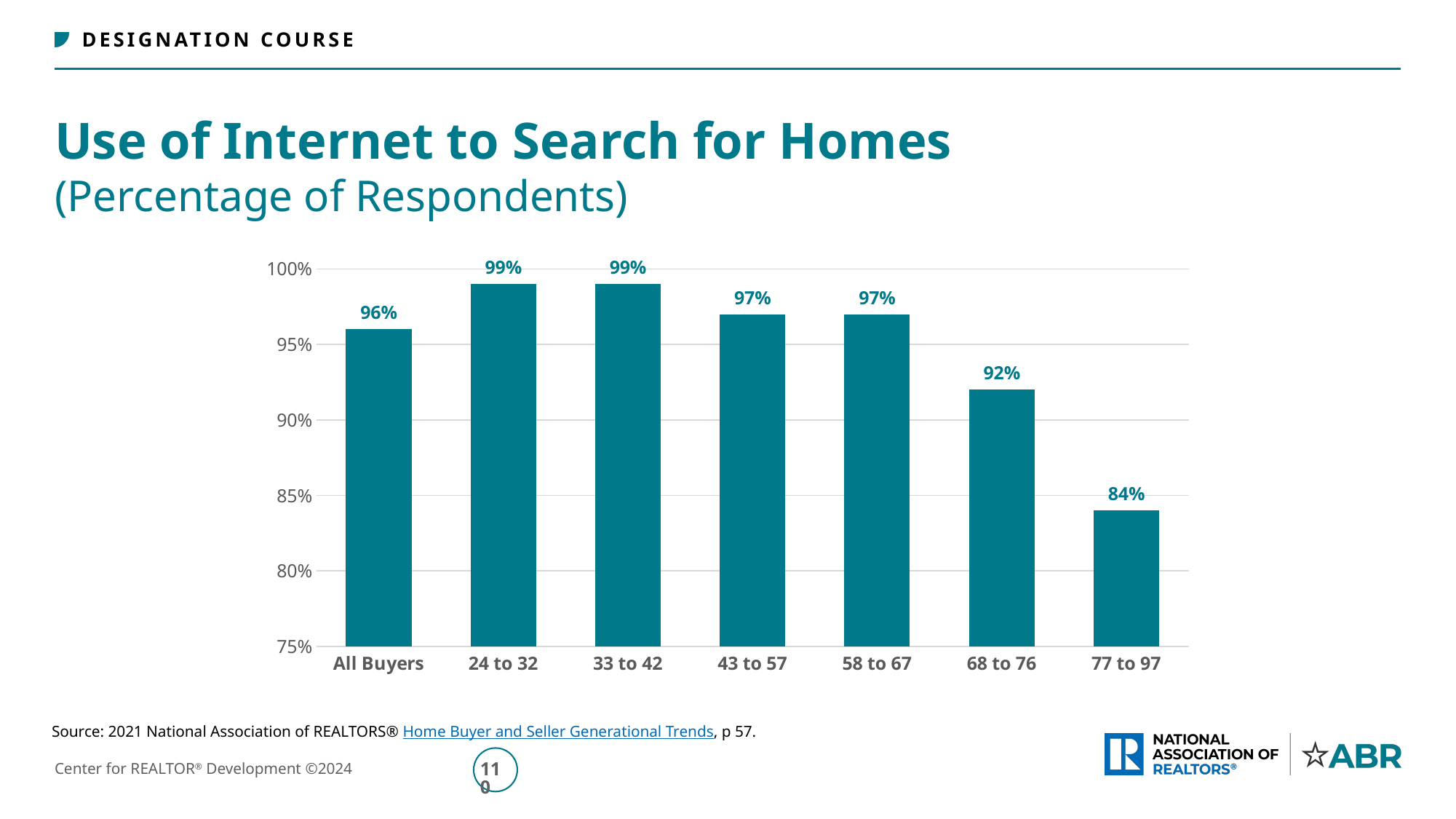
What is the difference between the values for 24 to 32 and 77 to 97? 15% Do the values rise or fall from the 33 to 42 group to the 77 to 97 group? Fall What percentage of All Buyers used the internet to search for homes? 96% How many categories are shown on the x axis? 7 What kind of chart is shown on the slide? Bar chart Which is larger, the value for 43 to 57 or the value for 68 to 76? 43 to 57 What is the value for the 68 to 76 age group? 92% What is the title of the chart? Use of Internet to Search for Homes (Percentage of Respondents) What is the difference between the values for All Buyers and 68 to 76? 4% Is the value for 77 to 97 greater or less than 85%? less What is the value for the 77 to 97 age group? 84% Which age group has the lowest percentage of respondents using the internet to search for homes? 77 to 97